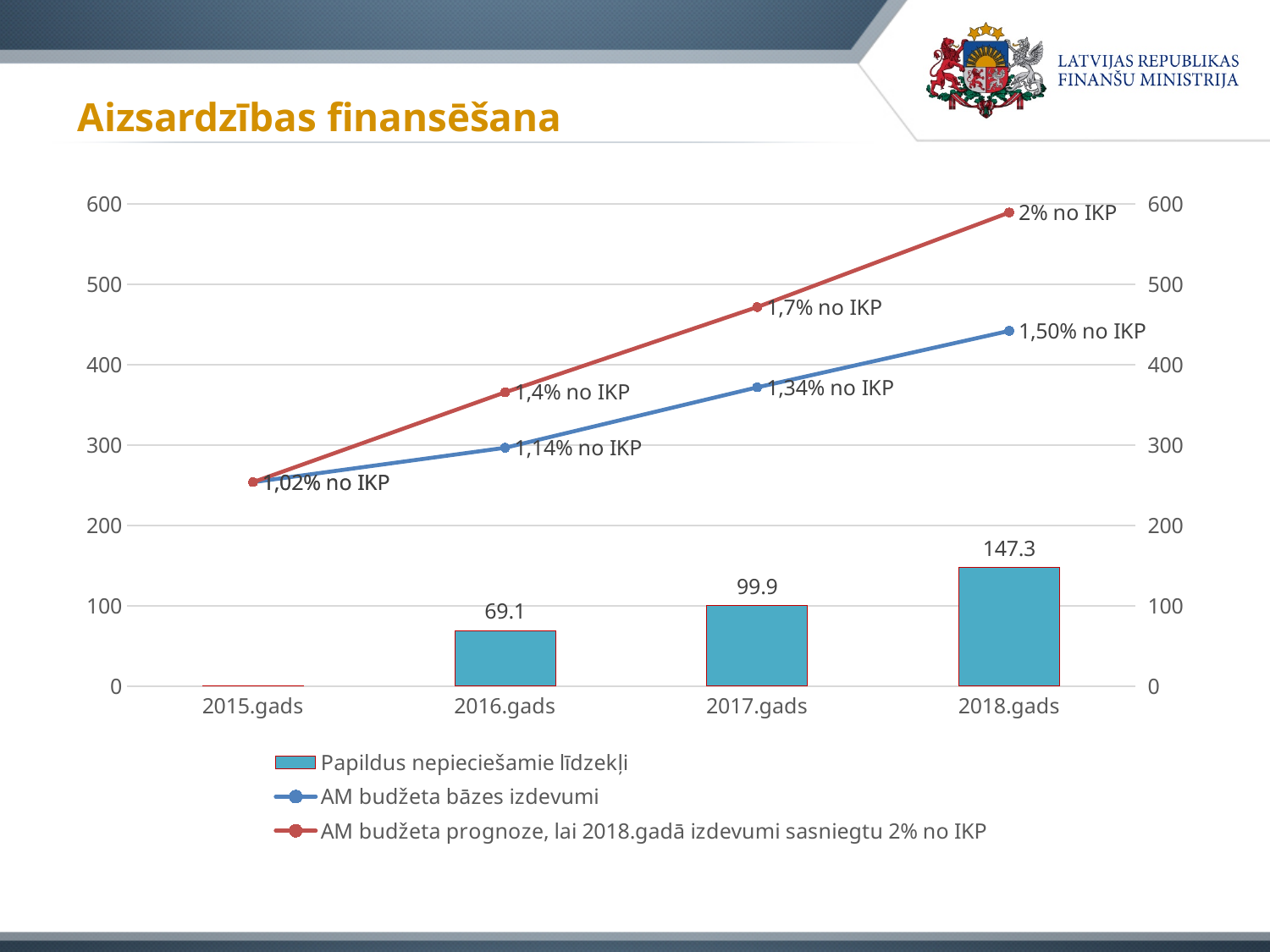
What data label is shown on the red forecast line ('AM budžeta prognoze...') for 2017.gads? 1,7% no IKP How many series does the legend list? 3 What is the difference between the 'Papildus nepieciešamie līdzekļi' values for 2017.gads and 2016.gads? 30.8 What is the value of the 'Papildus nepieciešamie līdzekļi' bar for 2018.gads? 147.3 Is the value of the 'AM budžeta bāzes izdevumi' line for 2017.gads greater or less than 400? less Do the 'Papildus nepieciešamie līdzekļi' bars rise or fall from 2016.gads to 2018.gads? rise Which year has the highest 'Papildus nepieciešamie līdzekļi' bar? 2018.gads What data label is shown on the 'AM budžeta bāzes izdevumi' line for 2018.gads? 1,50% no IKP What is the value of the 'Papildus nepieciešamie līdzekļi' bar for 2016.gads? 69.1 What is the value of the 'Papildus nepieciešamie līdzekļi' bar for 2017.gads? 99.9 What is the difference between the 'Papildus nepieciešamie līdzekļi' values for 2018.gads and 2017.gads? 47.4 Is the value of the red forecast line for 2018.gads greater or less than 500? greater